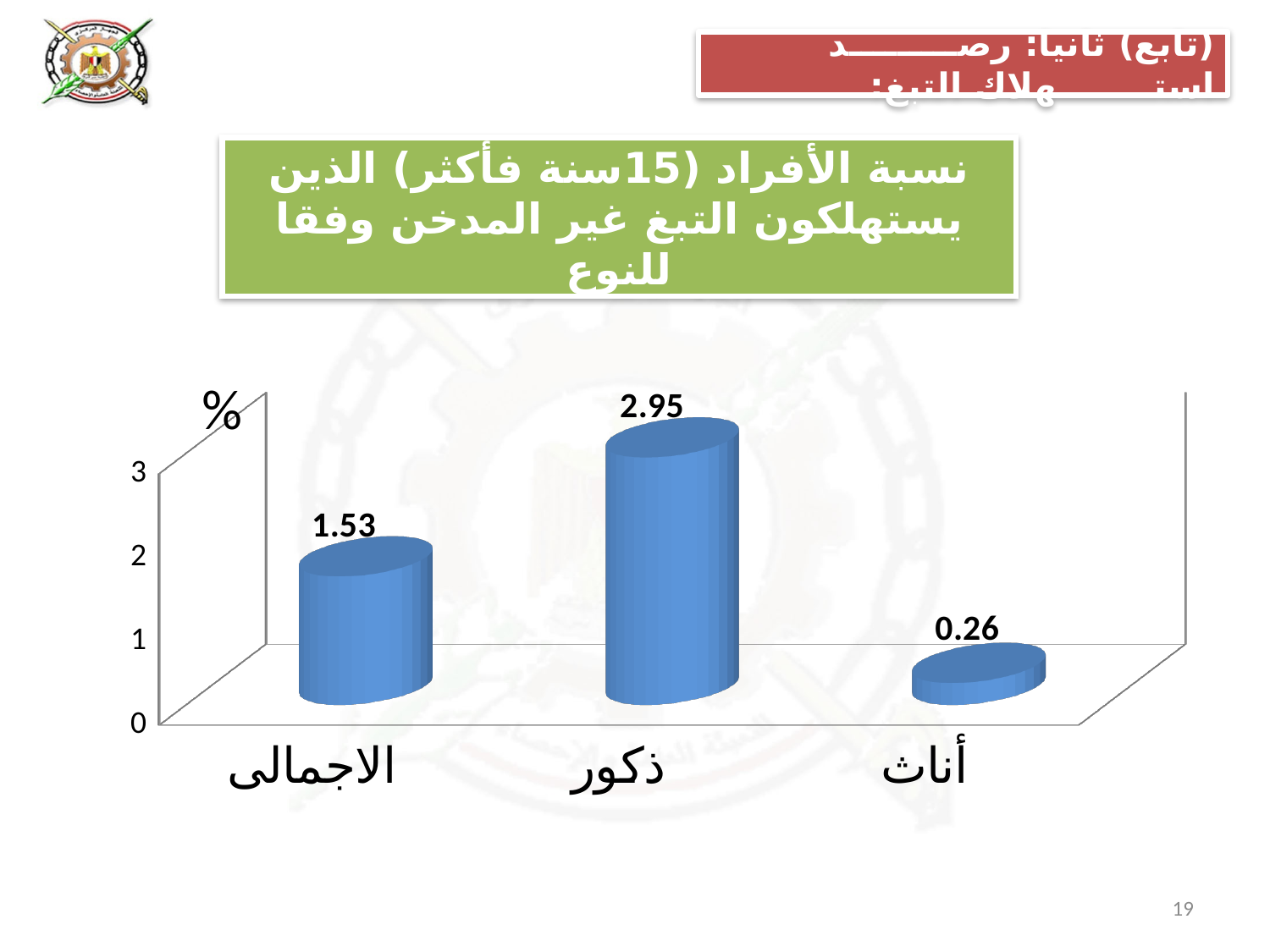
What is the difference between the values for ذكور and أناث? 2.69 How many categories are shown on the chart? 3 What is the value shown for ذكور (males)? 2.95 Which is larger, the value for الاجمالى or the value for أناث? الاجمالى What is the value shown for أناث (females)? 0.26 Is the value for ذكور greater or less than 2? greater What is the difference between the values for ذكور and الاجمالى? 1.42 What unit symbol is shown at the top of the vertical axis? % Which category has the lowest value? أناث Which category has the highest value? ذكور What is the value shown for الاجمالى (total)? 1.53 What kind of chart is shown on the slide? bar chart